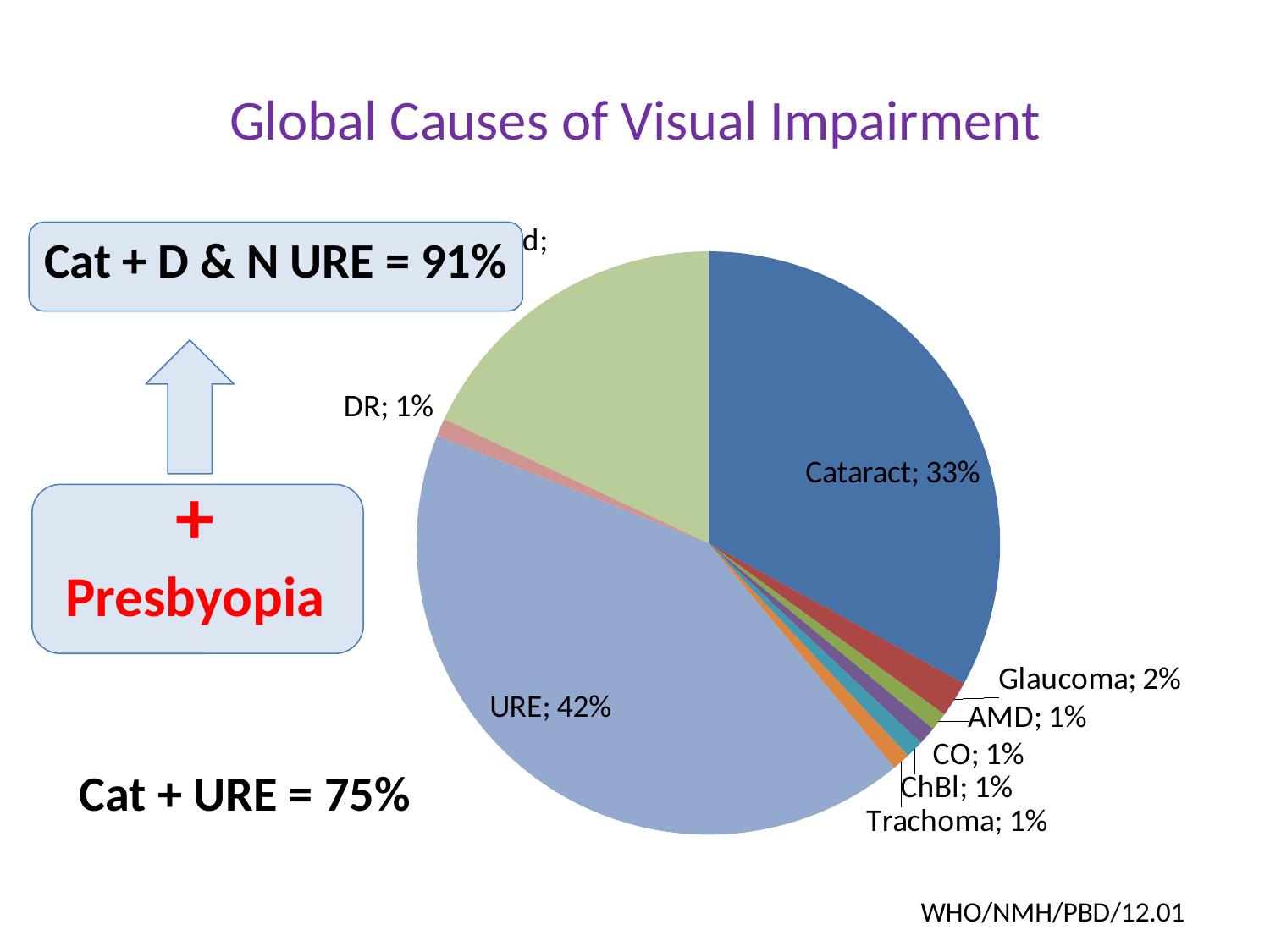
What percentage is shown for Glaucoma? 2% What is the difference between the Cataract share and the Glaucoma share? 31% What is the combined share of Cataract and URE? 75% What share of the pie does URE account for? 42% Which is larger, the share for Cataract or the share for URE? URE What percentage is shown for DR? 1% How many percentage points larger is the URE share than the Cataract share? 9% Which labelled cause has the largest share of the pie? URE What percentage is shown for Trachoma? 1% What kind of chart is shown on the slide? pie chart What is the title of the chart? Global Causes of Visual Impairment What share of the pie does Cataract account for? 33%